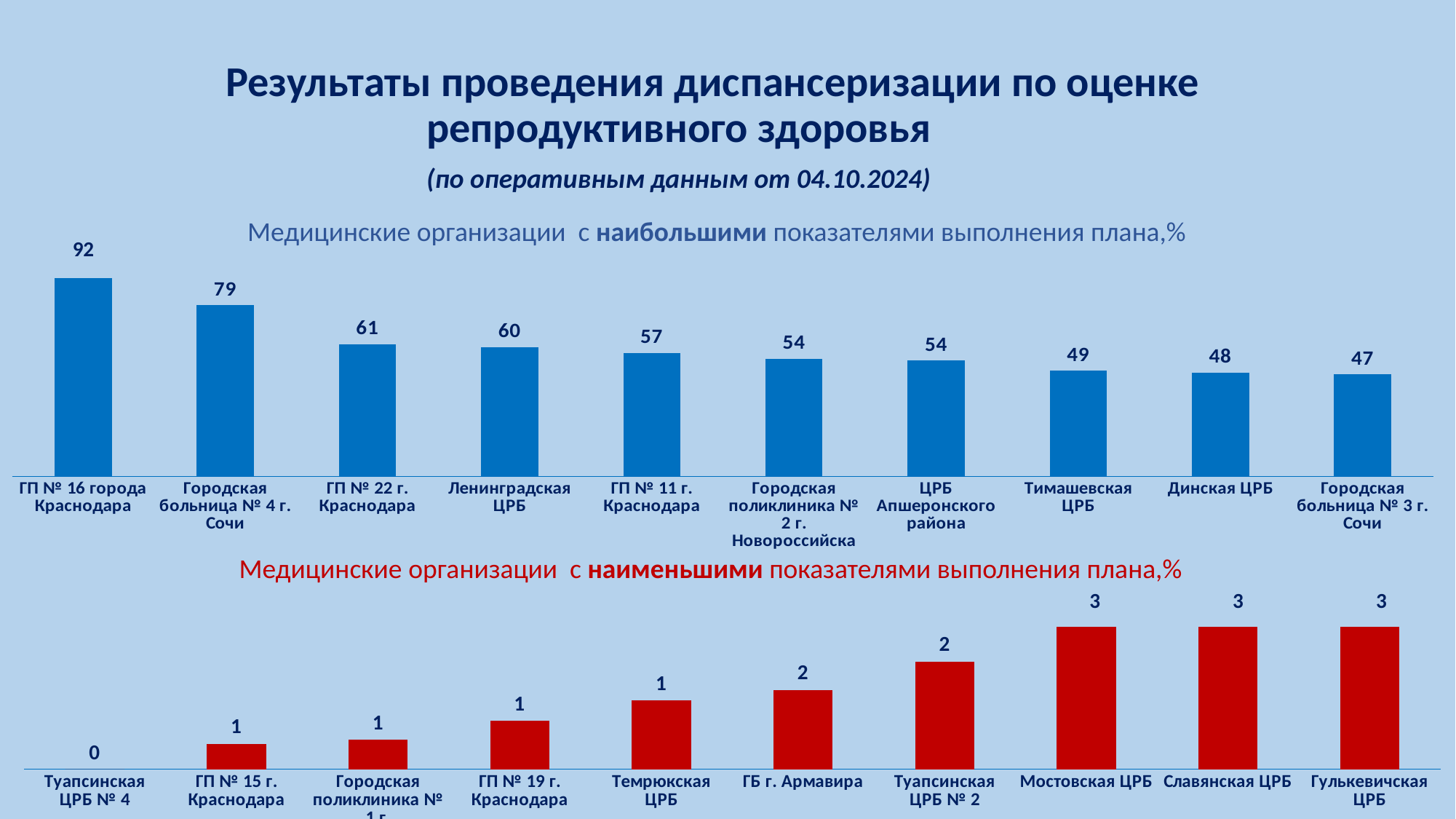
In the top chart (organisations with the highest plan fulfilment), what is the difference between ГП № 16 города Краснодара and Городская больница № 4 г. Сочи? 13 What colour are the bars in the bottom chart (organisations with the lowest plan fulfilment)? red In the bottom chart (organisations with the lowest plan fulfilment), what is the value for ГБ г. Армавира? 2 In the top chart (organisations with the highest plan fulfilment), what is the value for ГП № 16 города Краснодара? 92 In the top chart (organisations with the highest plan fulfilment), do the values rise or fall from left to right? fall In the bottom chart (organisations with the lowest plan fulfilment), what is the difference between Мостовская ЦРБ and Темрюкская ЦРБ? 2 In the top chart (organisations with the highest plan fulfilment), which organisation has the lowest value? Городская больница № 3 г. Сочи In the top chart (organisations with the highest plan fulfilment), what is the value for Ленинградская ЦРБ? 60 What type of chart is the bottom chart (organisations with the lowest plan fulfilment)? bar chart In the top chart (organisations with the highest plan fulfilment), which is larger: ГП № 22 г. Краснодара or Тимашевская ЦРБ? ГП № 22 г. Краснодара In the bottom chart (organisations with the lowest plan fulfilment), which organisation has the lowest value? Туапсинская ЦРБ № 4 In the top chart (organisations with the highest plan fulfilment), how many organisations are shown? 10